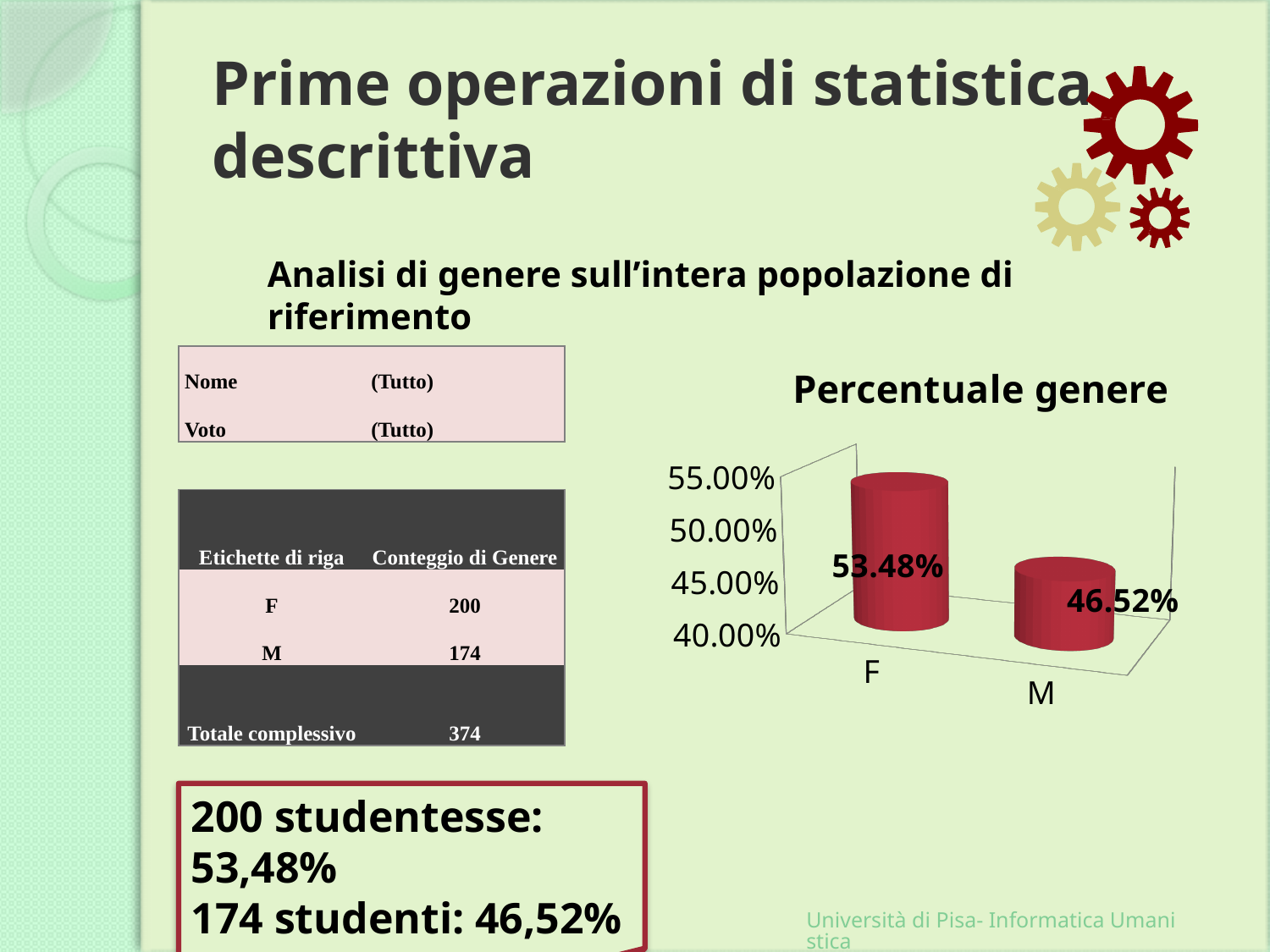
Which category has the highest value in the chart? F What is the difference between the values for F and M in the chart? 6.96% Which is larger in the chart, the value for F or the value for M? F Is the value for F greater or less than 50.00%? greater What is the value for M in the chart? 46.52% What is the value for F in the chart? 53.48% Which category has the lowest value in the chart? M Do the values rise or fall from F to M along the x axis? fall How many categories are shown on the x axis of the chart? 2 What kind of chart is shown under the title "Percentuale genere"? bar chart What is the title of the chart? Percentuale genere Is the value for M greater or less than 50.00%? less